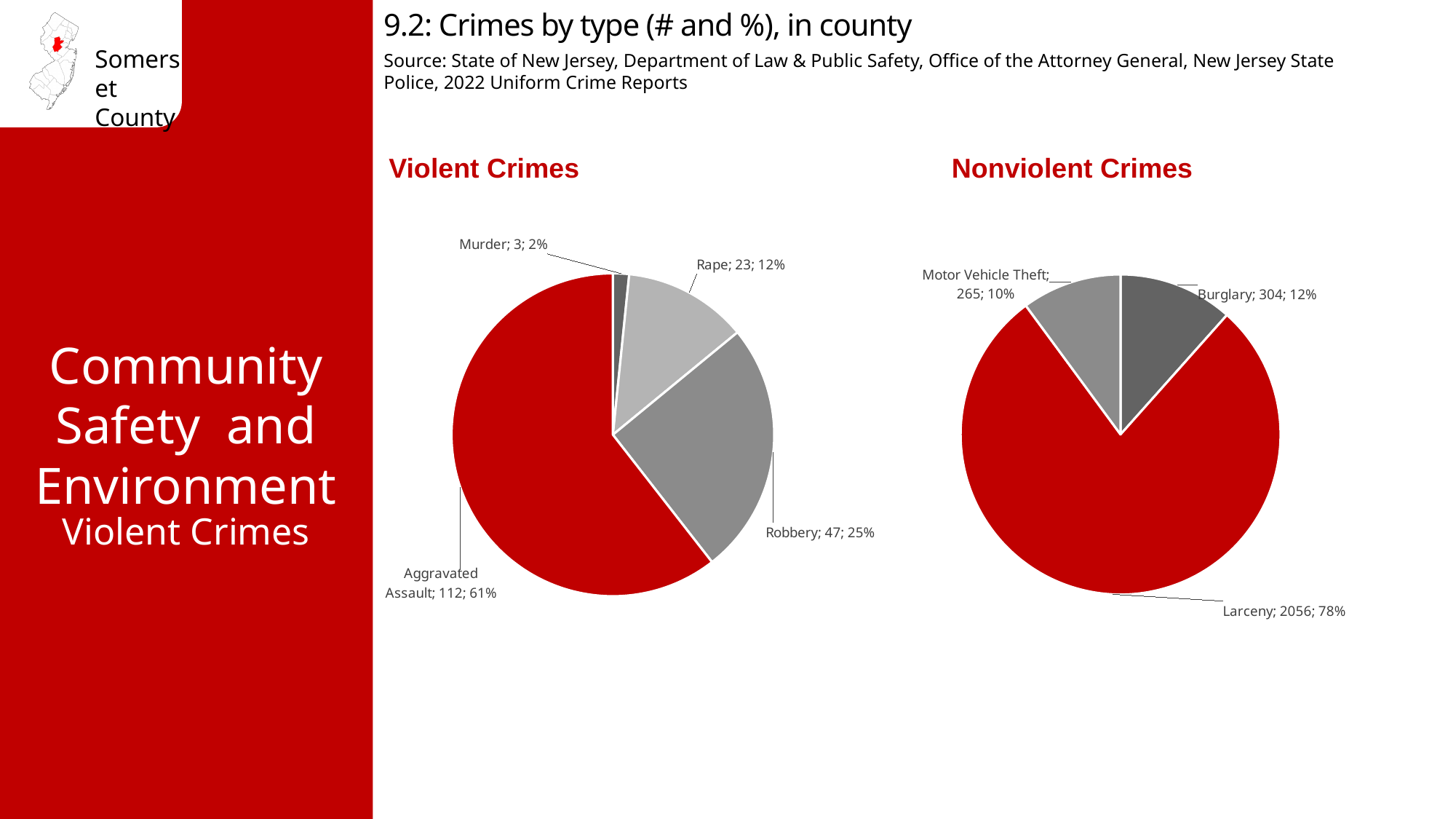
In the Nonviolent Crimes chart, what colour is the Larceny slice? Red In the Nonviolent Crimes chart, what percentage share does Motor Vehicle Theft have? 10% In the Violent Crimes chart, which category has the largest slice? Aggravated Assault In the Nonviolent Crimes chart, how many larcenies are shown? 2056 In the Nonviolent Crimes chart, which is larger, Burglary or Motor Vehicle Theft? Burglary How many categories does the Violent Crimes pie chart show? 4 In the Violent Crimes chart, how many aggravated assaults are shown? 112 In the Nonviolent Crimes chart, what is the difference between the number of burglaries and motor vehicle thefts? 39 What type of chart is used for Nonviolent Crimes? Pie chart In the Violent Crimes chart, what is the difference between the number of robberies and the number of rapes? 24 In the Violent Crimes chart, which category has the smallest slice? Murder In the Violent Crimes chart, what percentage share does Robbery have? 25%